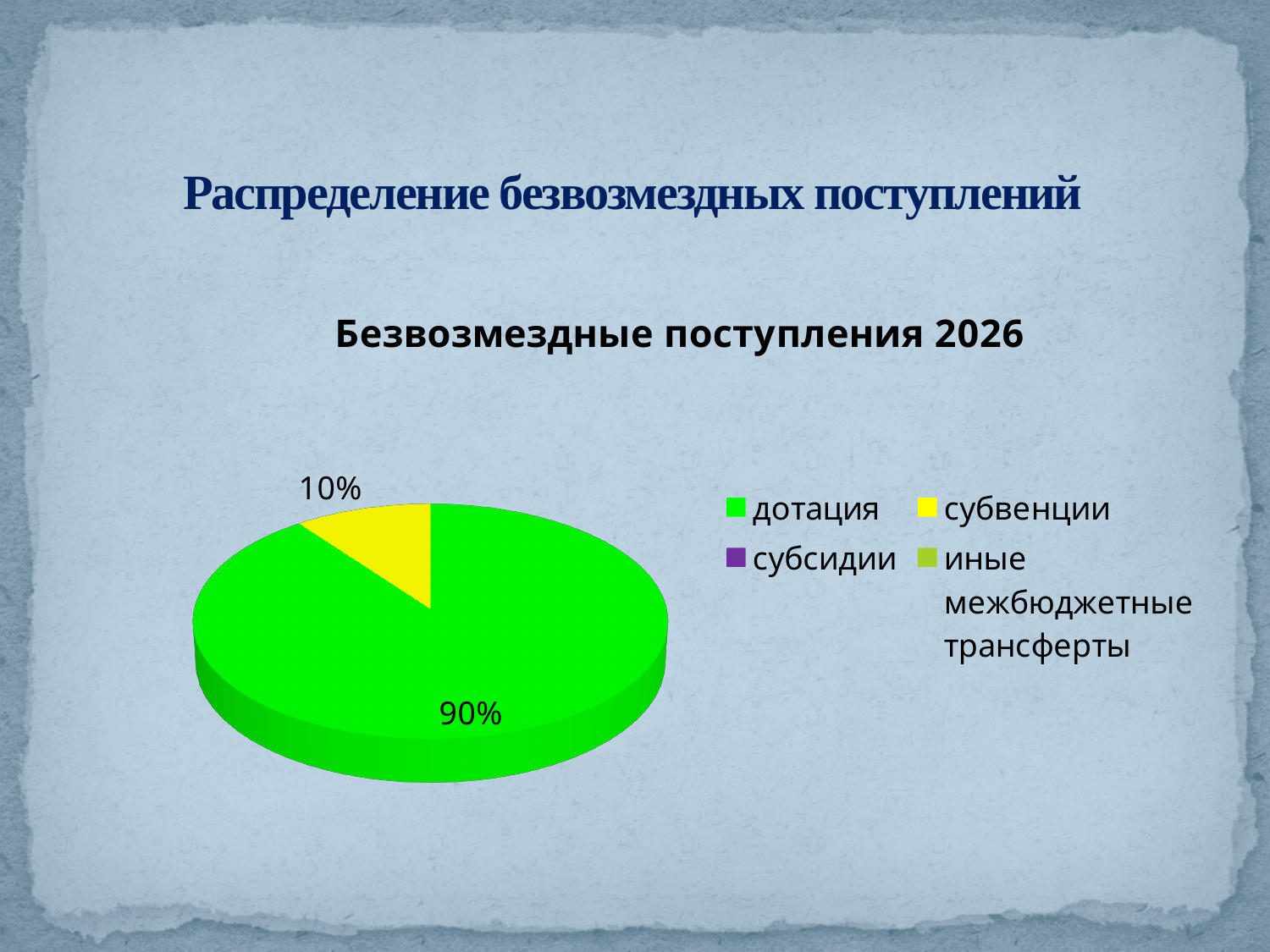
What colour is the slice for дотация? green What share of the pie does субвенции take? 10% What is the chart's title? Безвозмездные поступления 2026 How many entries does the legend list? 4 What is the difference in percentage points between the дотация share and the субвенции share? 80 Which category has the largest slice of the pie? дотация What share of the pie does дотация take? 90% Which is larger, the share for дотация or the share for субвенции? дотация Is the share for дотация greater or less than 50%? greater What kind of chart is shown on the slide? pie chart